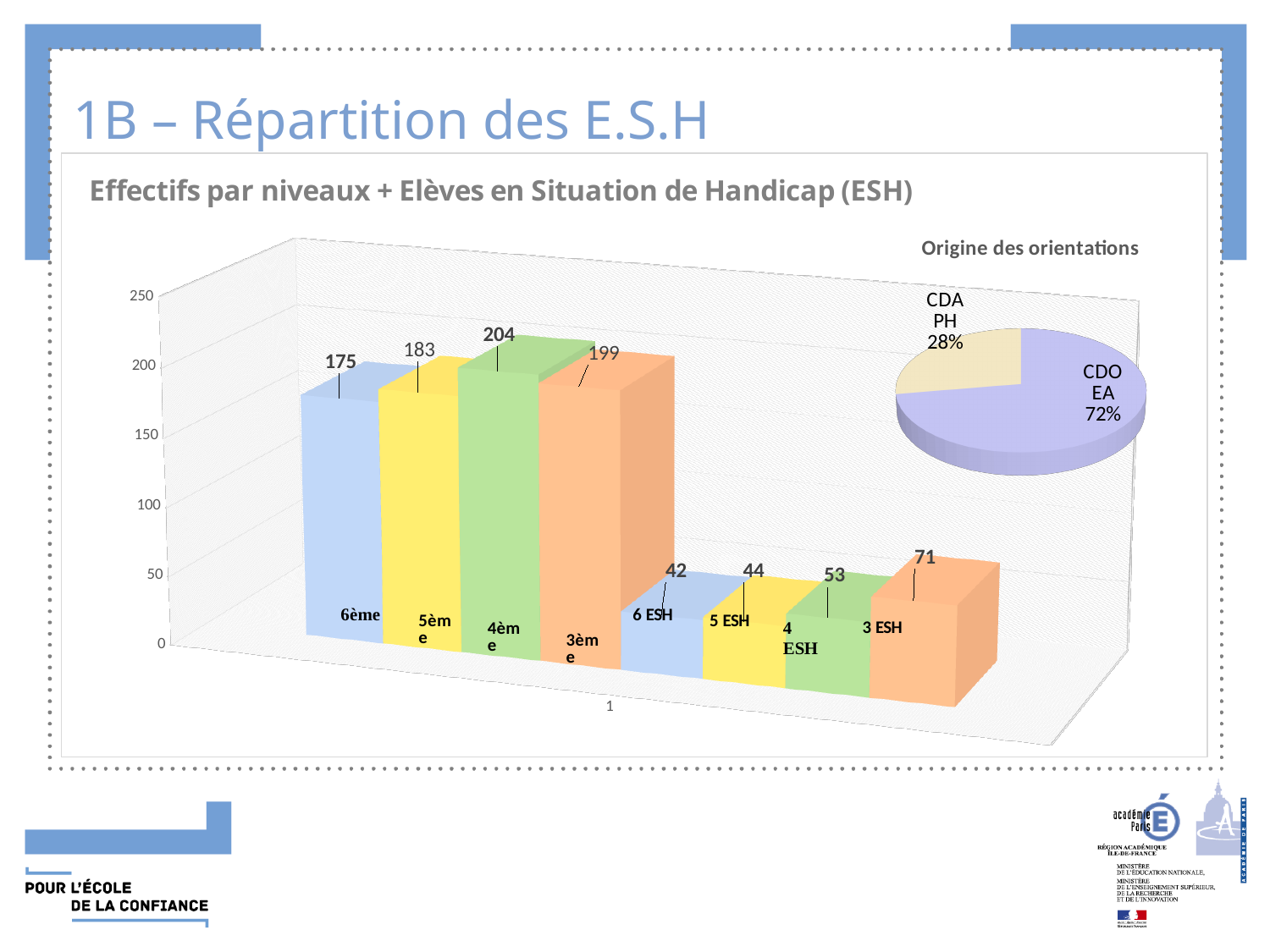
In the bar chart 'Effectifs par niveaux + Elèves en Situation de Handicap (ESH)', which category has the highest value? 4ème In the pie chart 'Origine des orientations', what share does CDO EA have? 72% In the bar chart 'Effectifs par niveaux + Elèves en Situation de Handicap (ESH)', what is the difference between the values for 3 ESH and 6 ESH? 29 In the bar chart 'Effectifs par niveaux + Elèves en Situation de Handicap (ESH)', how many bars are plotted? 8 In the pie chart 'Origine des orientations', what share does CDA PH have? 28% What kind of chart is 'Origine des orientations'? Pie chart In the bar chart 'Effectifs par niveaux + Elèves en Situation de Handicap (ESH)', which category has the lowest value? 6 ESH In the bar chart 'Effectifs par niveaux + Elèves en Situation de Handicap (ESH)', which is larger, the value for 5ème or the value for 6ème? 5ème In the bar chart 'Effectifs par niveaux + Elèves en Situation de Handicap (ESH)', what is the value for 3 ESH? 71 In the bar chart 'Effectifs par niveaux + Elèves en Situation de Handicap (ESH)', what is the value for 6ème? 175 What kind of chart is 'Effectifs par niveaux + Elèves en Situation de Handicap (ESH)'? Bar chart In the bar chart 'Effectifs par niveaux + Elèves en Situation de Handicap (ESH)', what is the difference between the values for 4ème and 3ème? 5